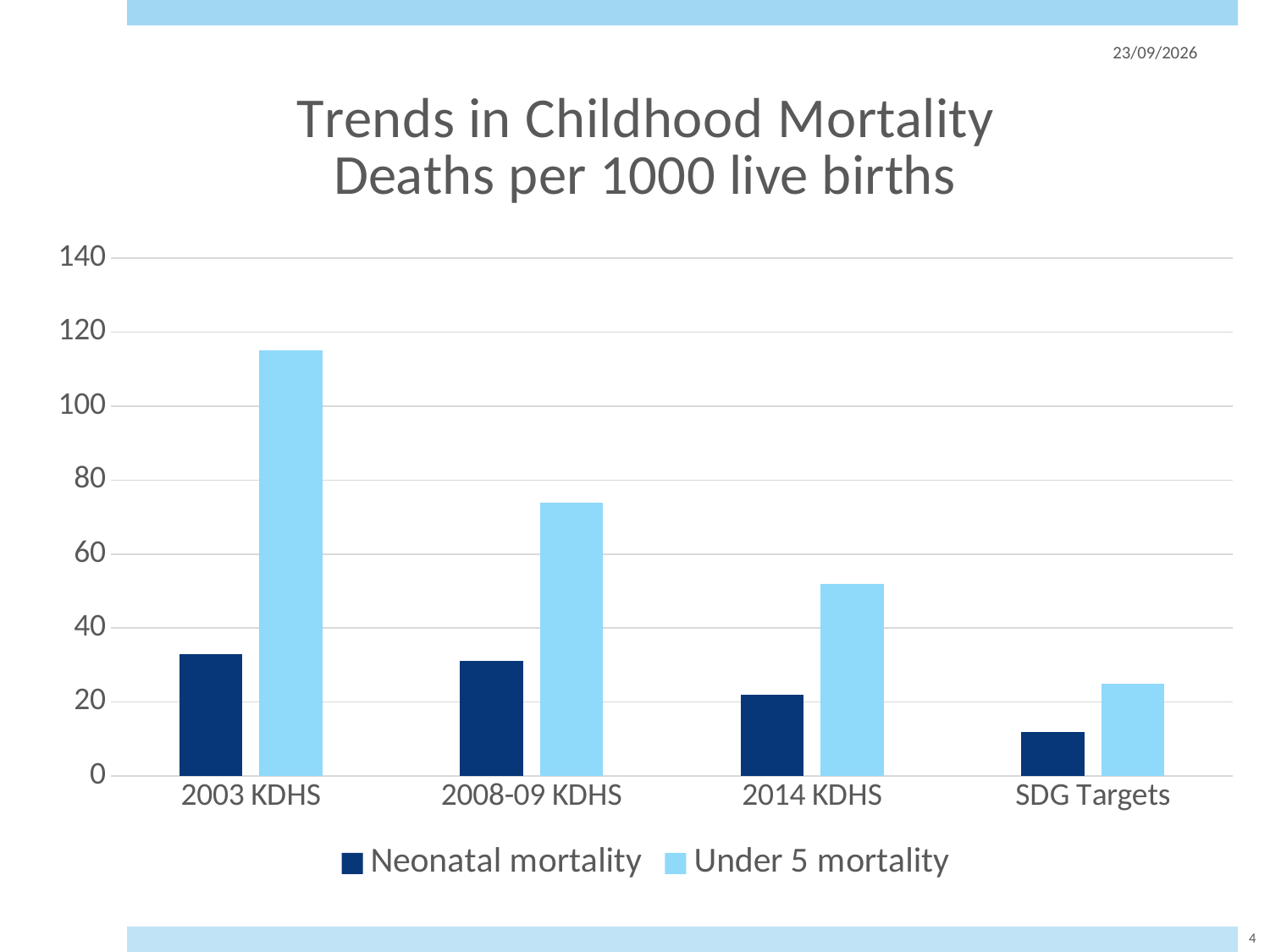
Which category has the highest Under 5 mortality value? 2003 KDHS Which series is shown in dark blue in the legend? Neonatal mortality What kind of chart is shown on the slide? Bar chart Which category has the lowest Neonatal mortality value? SDG Targets Which is larger: Under 5 mortality for 2008-09 KDHS or Under 5 mortality for 2014 KDHS? 2008-09 KDHS Which category has the lowest Under 5 mortality value? SDG Targets Is the Under 5 mortality value for 2014 KDHS greater or less than 60? less Is the Under 5 mortality value for 2003 KDHS greater or less than 100? greater How many series does the legend list? 2 How many categories are shown on the x axis? 4 Do the Under 5 mortality values rise or fall from 2003 KDHS to SDG Targets? Fall Is the Neonatal mortality value for SDG Targets greater or less than 20? less